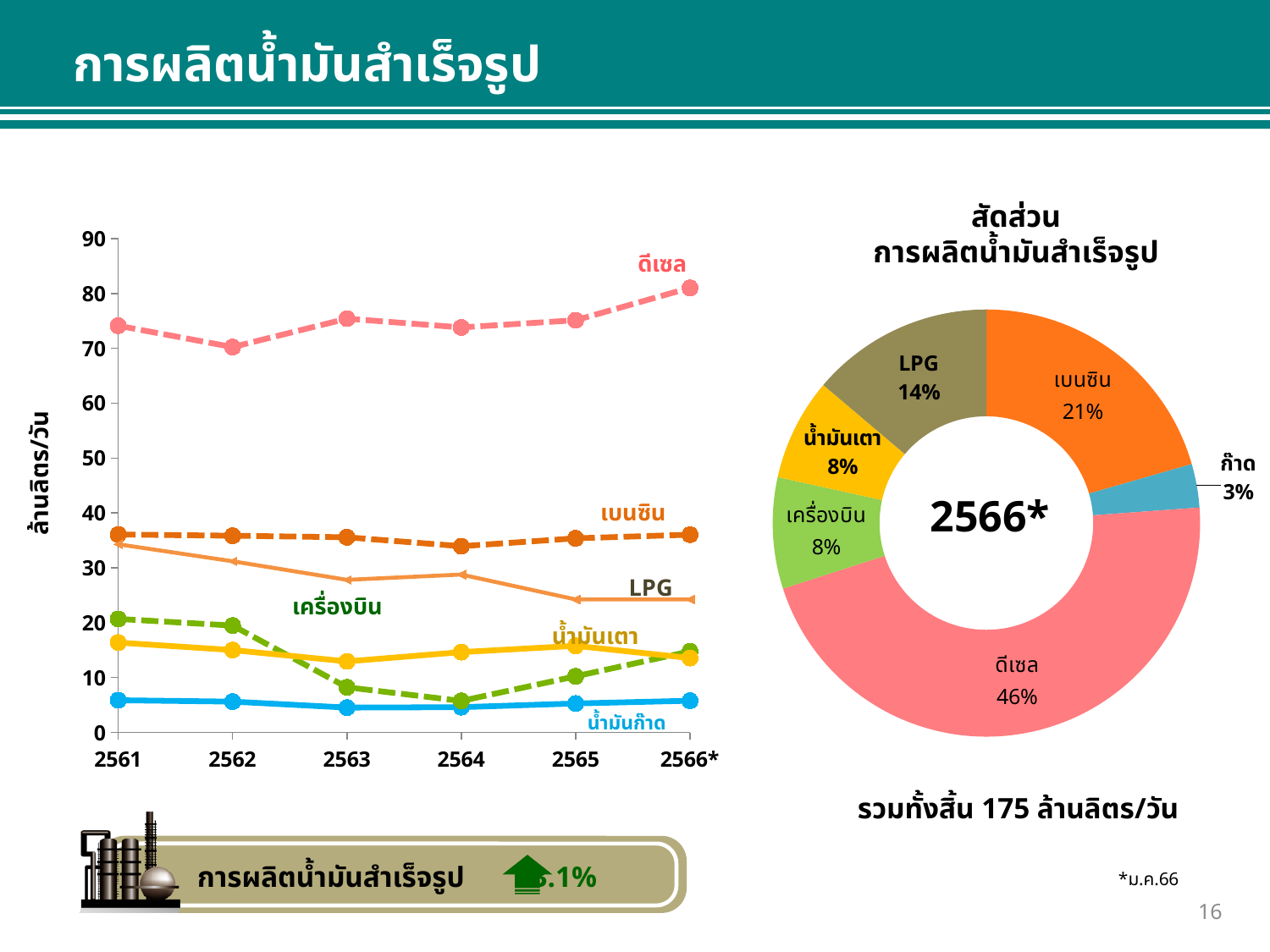
In the pie chart on the right, what share does LPG have? 14% In the line chart on the left, is the value for ดีเซล in 2566* greater or less than 70? greater In the pie chart on the right, which category has the largest share? ดีเซล In the pie chart on the right, which category has the smallest share? ก๊าด In the pie chart titled สัดส่วนการผลิตน้ำมันสำเร็จรูป, what share does ดีเซล have? 46% In the line chart on the left, does the LPG series rise or fall from 2561 to 2566*? fall In the line chart on the left, how many series are plotted? 6 In the pie chart on the right, what is the difference in percentage points between เบนซิน and LPG? 7% In the line chart on the left, which is larger in 2561, ดีเซล or เบนซิน? ดีเซล What kind of chart is the chart on the left of the slide? line chart In the line chart on the left, how many years are shown on the x axis? 6 In the pie chart on the right, how many slices are there? 6